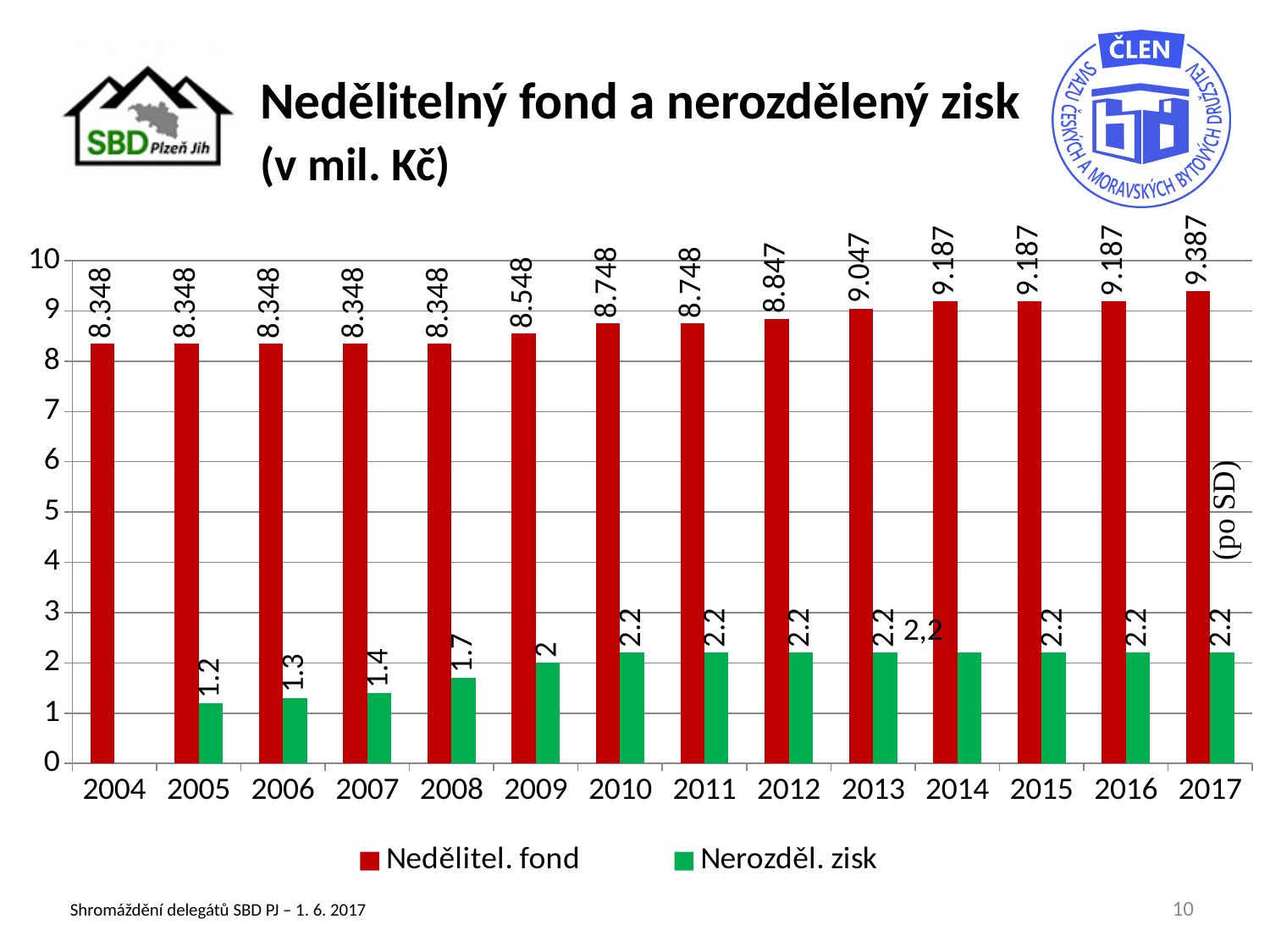
What is the value of Nedělitel. fond for 2012? 8.847 How many years are shown on the x axis? 14 Which year has the highest value of Nedělitel. fond? 2017 What is the difference between the Nedělitel. fond values for 2017 and 2004? 1.039 Does the Nedělitel. fond series rise or fall from 2004 to 2017? rise Which is larger, the Nedělitel. fond value for 2013 or for 2009? 2013 What kind of chart is shown on the slide? bar chart What is the value of Nedělitel. fond for 2017? 9.387 Is the value of Nedělitel. fond for 2014 greater or less than 9? greater What is the value of Nerozděl. zisk for 2008? 1.7 How many series does the legend list? 2 Which year has the lowest value of Nerozděl. zisk among the years where it is plotted? 2005